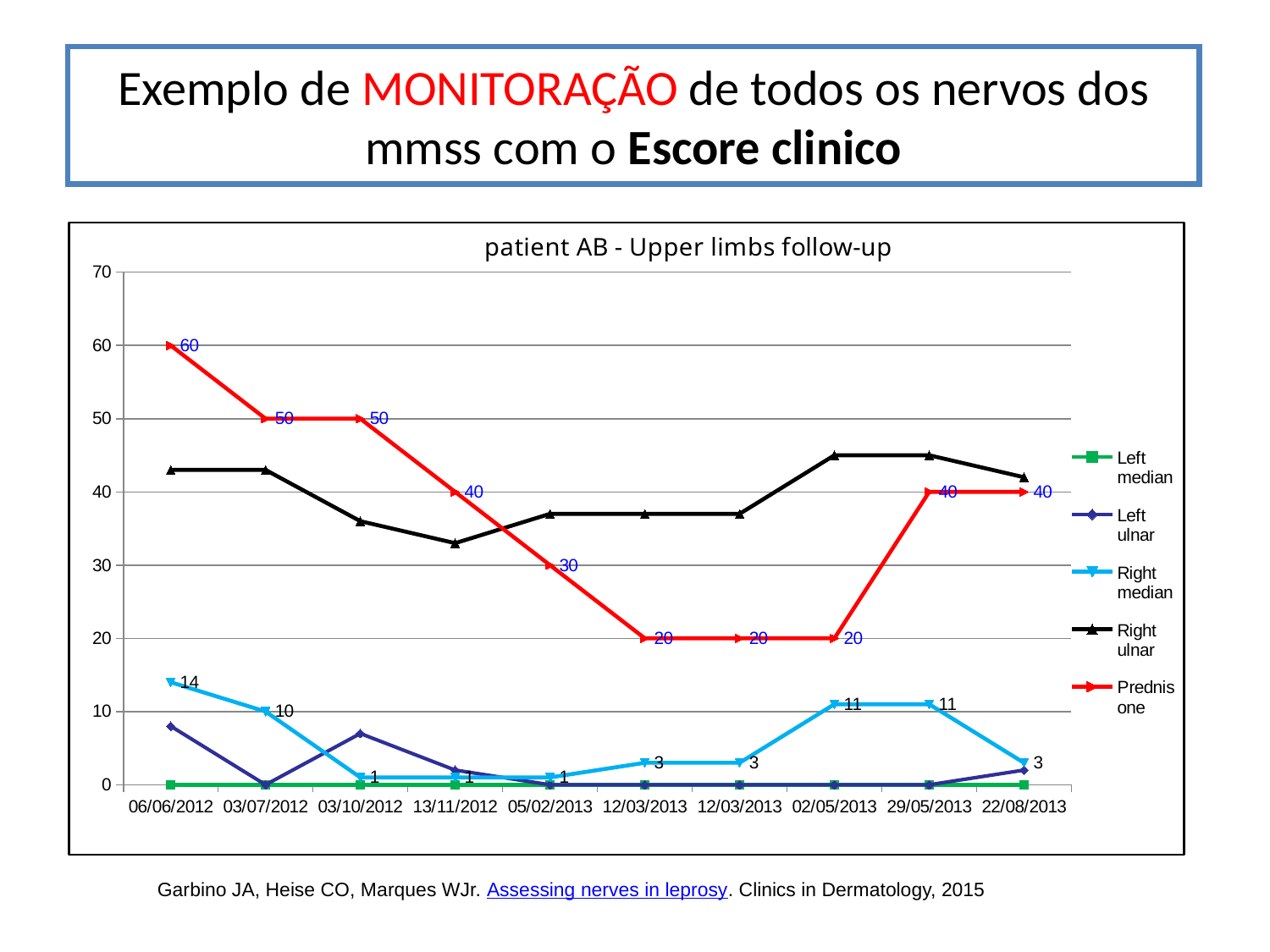
Is the Right ulnar value on 06/06/2012 greater or less than 40? greater What is the title of the chart? patient AB - Upper limbs follow-up What is the Right median value on 06/06/2012? 14 How many series does the legend list? 5 What is the Prednisone value on 22/08/2013? 40 What is the difference between the Prednisone value on 06/06/2012 and on 22/08/2013? 20 What is the Prednisone value on 06/06/2012? 60 On 06/06/2012, which is larger: the Prednisone value or the Right ulnar value? Prednisone How many dates are shown along the x axis? 10 On which date is the Prednisone value highest? 06/06/2012 What kind of chart is shown on the slide? line chart What is the Right median value on 02/05/2013? 11